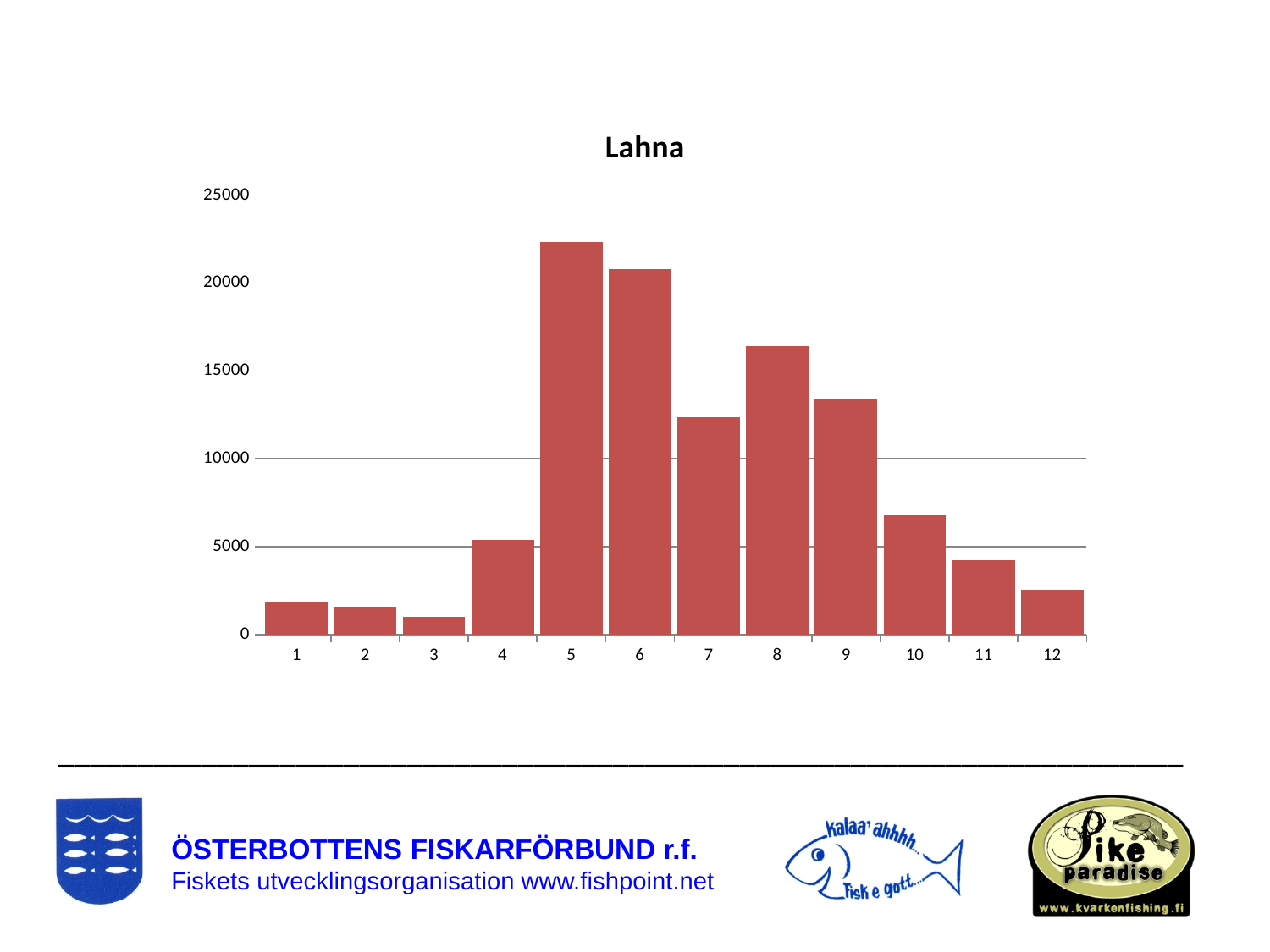
Is the value for category 11 greater or less than 5000? less Which has the larger value, category 8 or category 9? 8 Which category has the highest value in the chart? 5 Is the value for category 10 greater or less than 5000? greater Is the value for category 5 greater or less than 20000? greater Which category has the lowest value in the chart? 3 What is the title of the chart? Lahna Do the values rise or fall from category 9 to category 12? fall How many categories are shown on the x axis of the chart? 12 What kind of chart is shown on the slide? bar chart